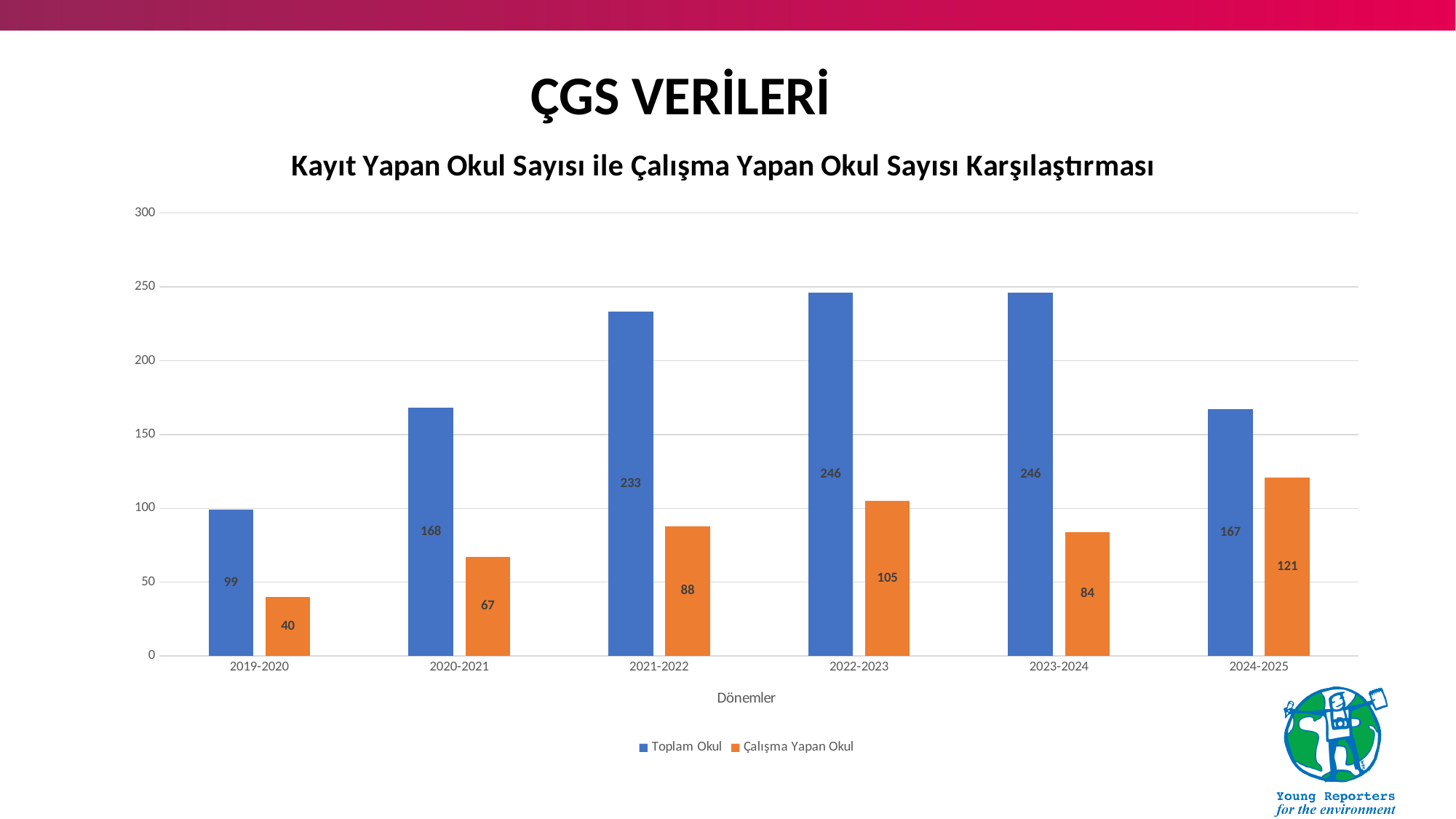
Which period has the lowest value for Toplam Okul? 2019-2020 What kind of chart is shown on the slide? bar chart Which period has the highest value for Çalışma Yapan Okul? 2024-2025 What is the value of Toplam Okul for 2021-2022? 233 What is the value of Çalışma Yapan Okul for 2024-2025? 121 How many periods are shown on the x axis? 6 How many series does the legend list? 2 What is the difference between Toplam Okul and Çalışma Yapan Okul in 2022-2023? 141 What is the label of the x axis? Dönemler Which is larger: Çalışma Yapan Okul in 2023-2024 or in 2021-2022? 2021-2022 What is the value of Çalışma Yapan Okul for 2019-2020? 40 Is the value of Toplam Okul for 2020-2021 greater or less than 150? greater